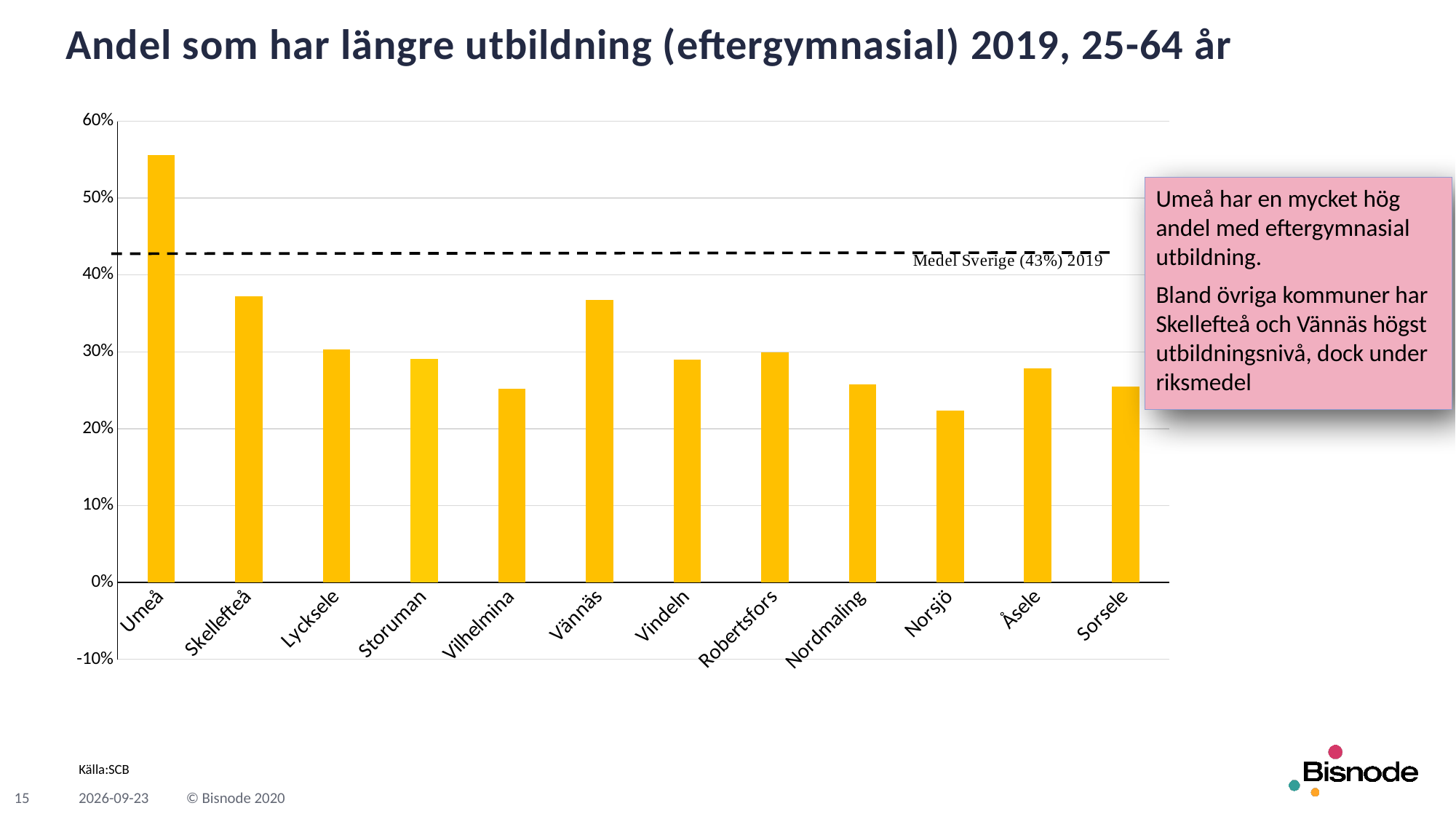
How many municipalities are shown on the x axis of the chart? 12 Is the value for Nordmaling greater or less than 30%? less Is the value for Skellefteå greater or less than 40%? less Which has a higher value, Umeå or Skellefteå? Umeå Which municipality has the lowest share of people with post-secondary education? Norsjö What is the title of the chart on the slide? Andel som har längre utbildning (eftergymnasial) 2019, 25-64 år Which municipality has the highest share of people with post-secondary education? Umeå Is the value for Umeå greater or less than 50%? greater Which has a higher value, Lycksele or Vilhelmina? Lycksele What value does the dashed reference line labelled 'Medel Sverige' represent? 43% What kind of chart is shown on the slide? bar chart